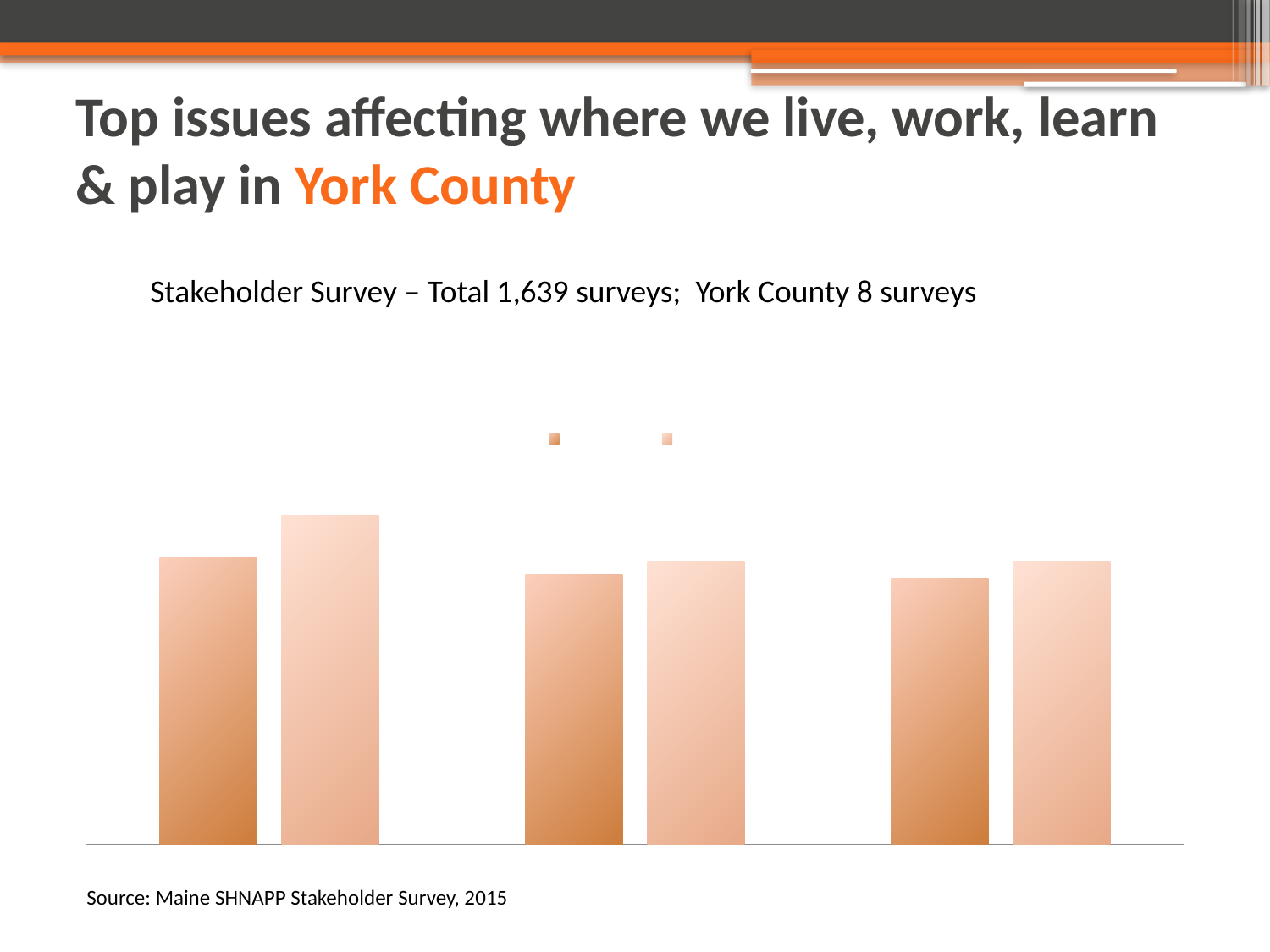
Which group of bars, counting from the left, contains the tallest bar in the chart? the first (leftmost) group In the middle group of bars, is the darker orange bar or the lighter orange bar taller? the lighter orange bar How many bars are plotted in total in the chart? 6 Do the darker orange bars rise or fall from left to right across the three groups? fall In the leftmost group of bars, is the darker orange bar or the lighter orange bar taller? the lighter orange bar Which bar in the chart is the shortest? the darker orange bar in the rightmost group What colours are used for the two series in the chart? darker orange and lighter orange In the rightmost group of bars, is the darker orange bar or the lighter orange bar taller? the lighter orange bar What kind of chart is shown on the slide? bar chart What source is cited below the chart? Maine SHNAPP Stakeholder Survey, 2015 How many series does the chart's legend list? 2 How many groups of bars are plotted in the chart? 3